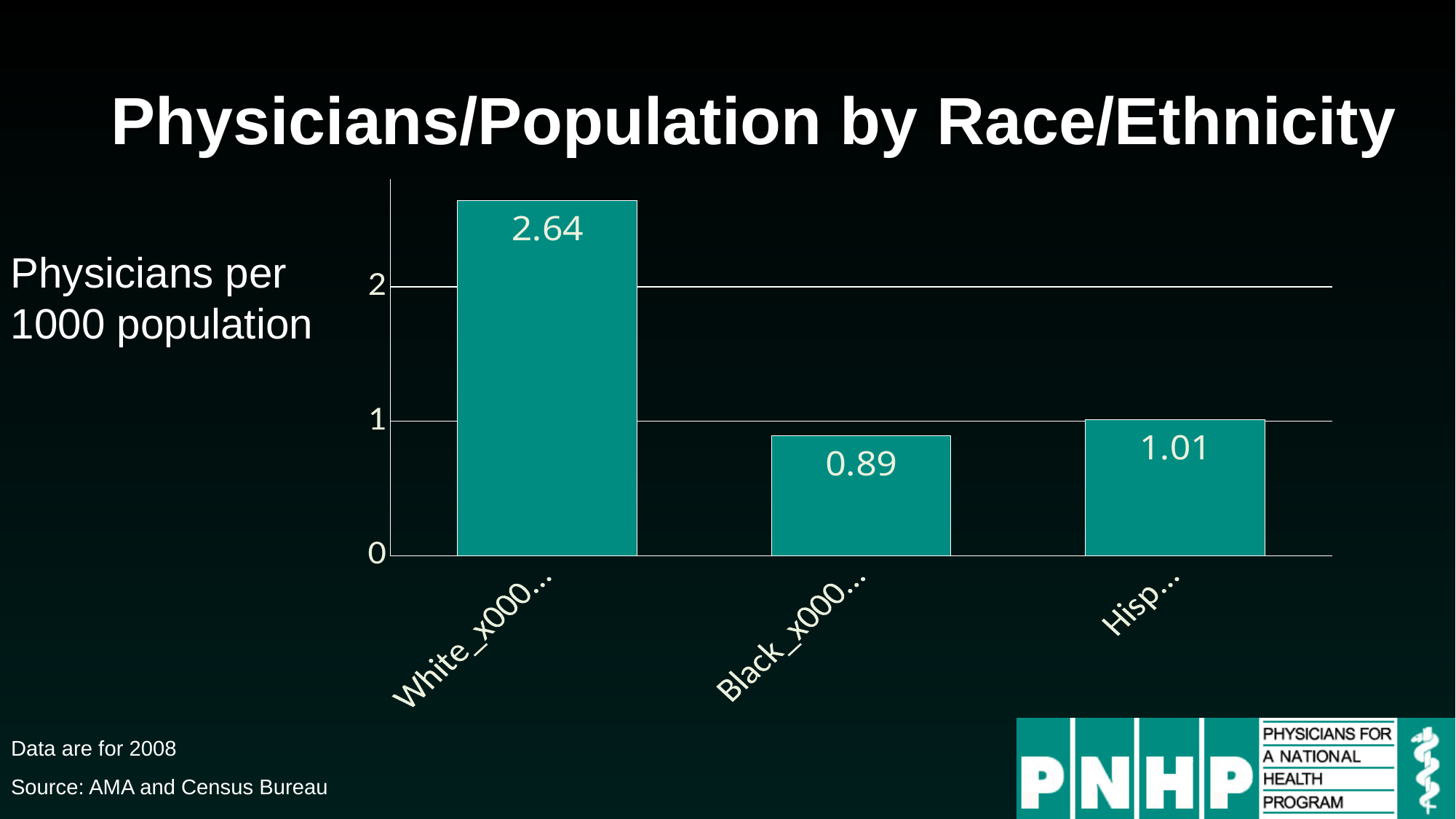
What is the difference between the values for the Hispanic bar and the Black bar? 0.12 Which category has the lowest physicians per 1000 population? Black What unit does the text to the left of the chart say the values are measured in? Physicians per 1000 population What is the value for the Hispanic bar (labelled 'Hisp…') in the chart? 1.01 What is the difference between the values for White and Black? 1.75 What is the value for White in the Physicians/Population by Race/Ethnicity chart? 2.64 What is the value for Black in the chart? 0.89 How many categories are shown in the chart? 3 Is the value for White greater or less than 2? greater Which is larger, the value for Black or the value for the Hispanic bar? Hispanic What type of chart is shown on the slide? bar chart Which category has the highest physicians per 1000 population? White